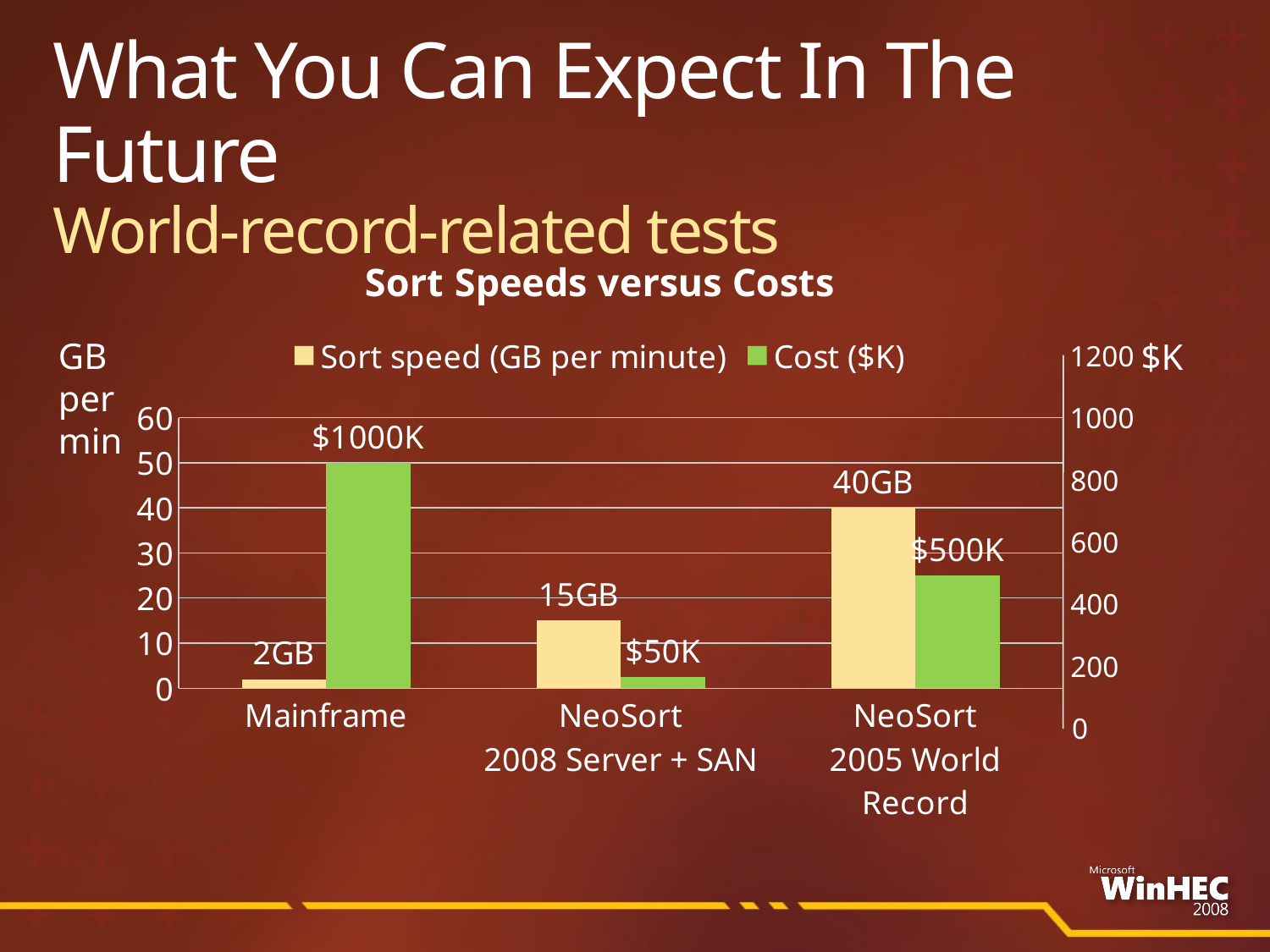
What is the cost for Mainframe? $1000K Which category has the lowest cost? NeoSort 2008 Server + SAN What is the sort speed for Mainframe? 2GB What is the difference in sort speed between NeoSort 2005 World Record and NeoSort 2008 Server + SAN? 25GB What kind of chart is this? Bar chart Which has a higher cost, Mainframe or NeoSort 2005 World Record? Mainframe How many categories are shown on the x axis? 3 What is the cost for NeoSort 2008 Server + SAN? $50K How many series does the legend list? 2 Which category has the highest sort speed? NeoSort 2005 World Record What is the sort speed for NeoSort 2005 World Record? 40GB What is the title of the chart? Sort Speeds versus Costs